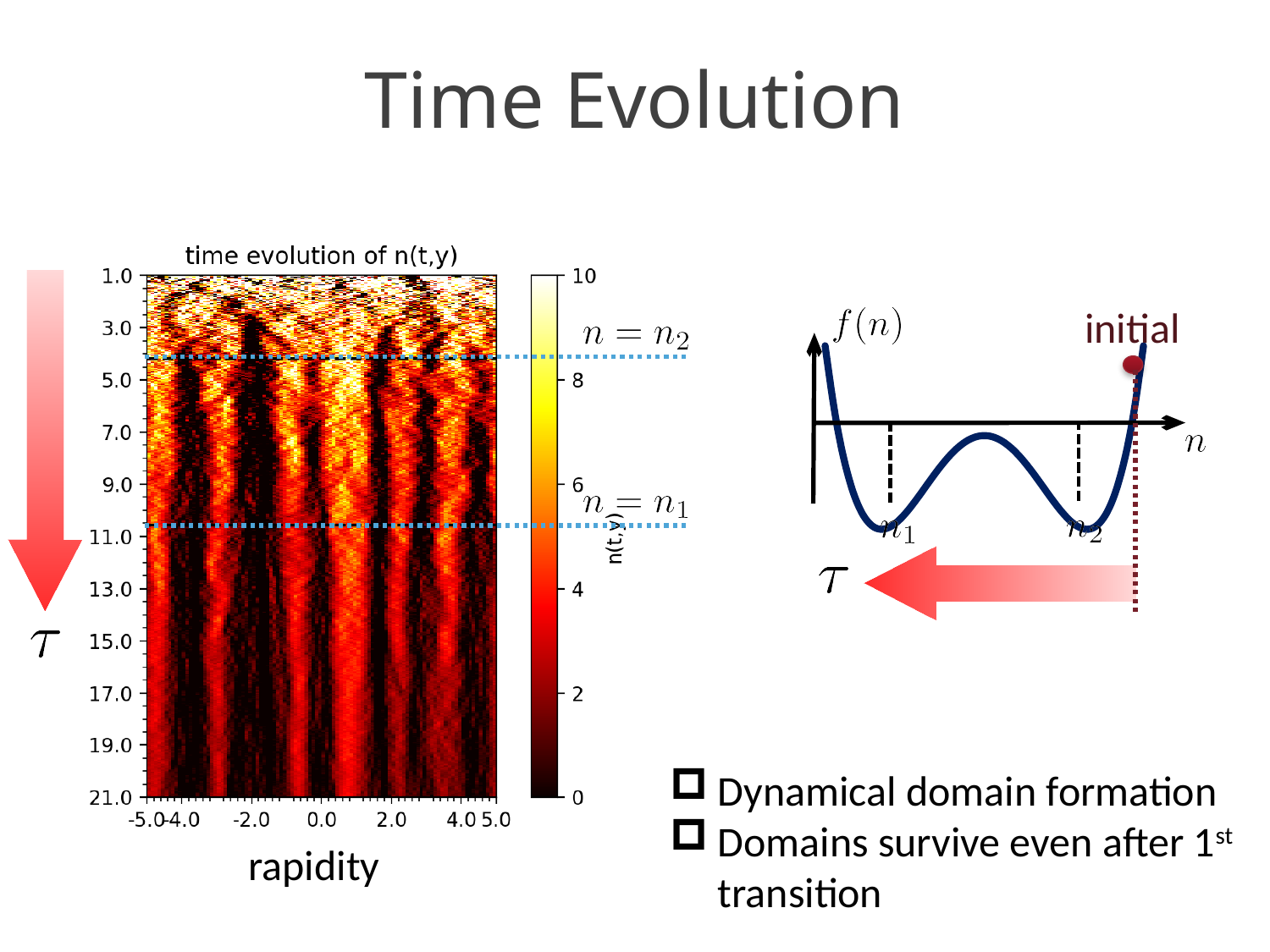
In the left heatmap, what is the range of rapidity values shown on the horizontal axis? -5.0 to 5.0 In the right schematic plot of f(n), how many minima are labelled on the n axis? 2 In the left heatmap, what is the smallest τ value labelled on the vertical axis? 1.0 In the left heatmap, does the overall value of n(t,y) increase or decrease as τ increases from 1.0 to 21.0? decrease In the left heatmap, what is the label of the horizontal axis? rapidity In the left heatmap, what is the minimum value shown on the colour bar? 0 In the left heatmap, what is the largest τ value labelled on the vertical axis? 21.0 In the right schematic plot of f(n), what is the label of the vertical axis? f(n) In the left heatmap, what is the maximum value shown on the colour bar? 10 In the left heatmap, how many τ tick labels are shown on the vertical axis? 11 In the left heatmap, which dotted horizontal line occurs at an earlier τ: n = n2 or n = n1? n = n2 What kind of chart is the plot on the left titled 'time evolution of n(t,y)'? heatmap